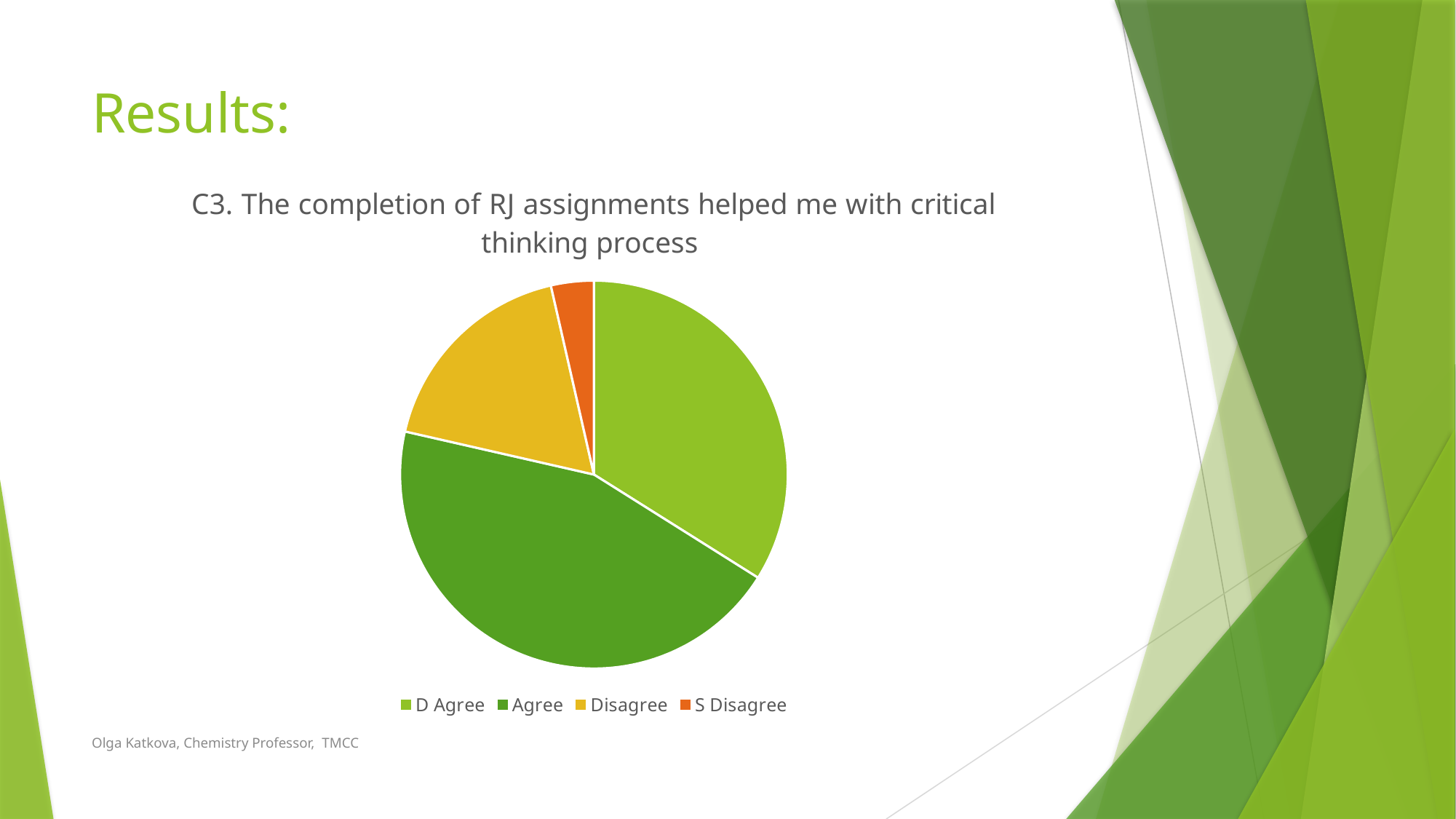
Which slice is larger, D Agree or Disagree? D Agree How many slices does the pie chart have? 4 What kind of chart is shown on the slide? pie chart How many entries does the legend list? 4 Which category has the smallest slice of the pie? S Disagree What is the title of the chart? C3. The completion of RJ assignments helped me with critical thinking process Which slice is larger, Agree or D Agree? Agree Which slice is larger, Disagree or S Disagree? Disagree Which category is shown in orange in the pie chart? S Disagree Which category has the largest slice of the pie? Agree